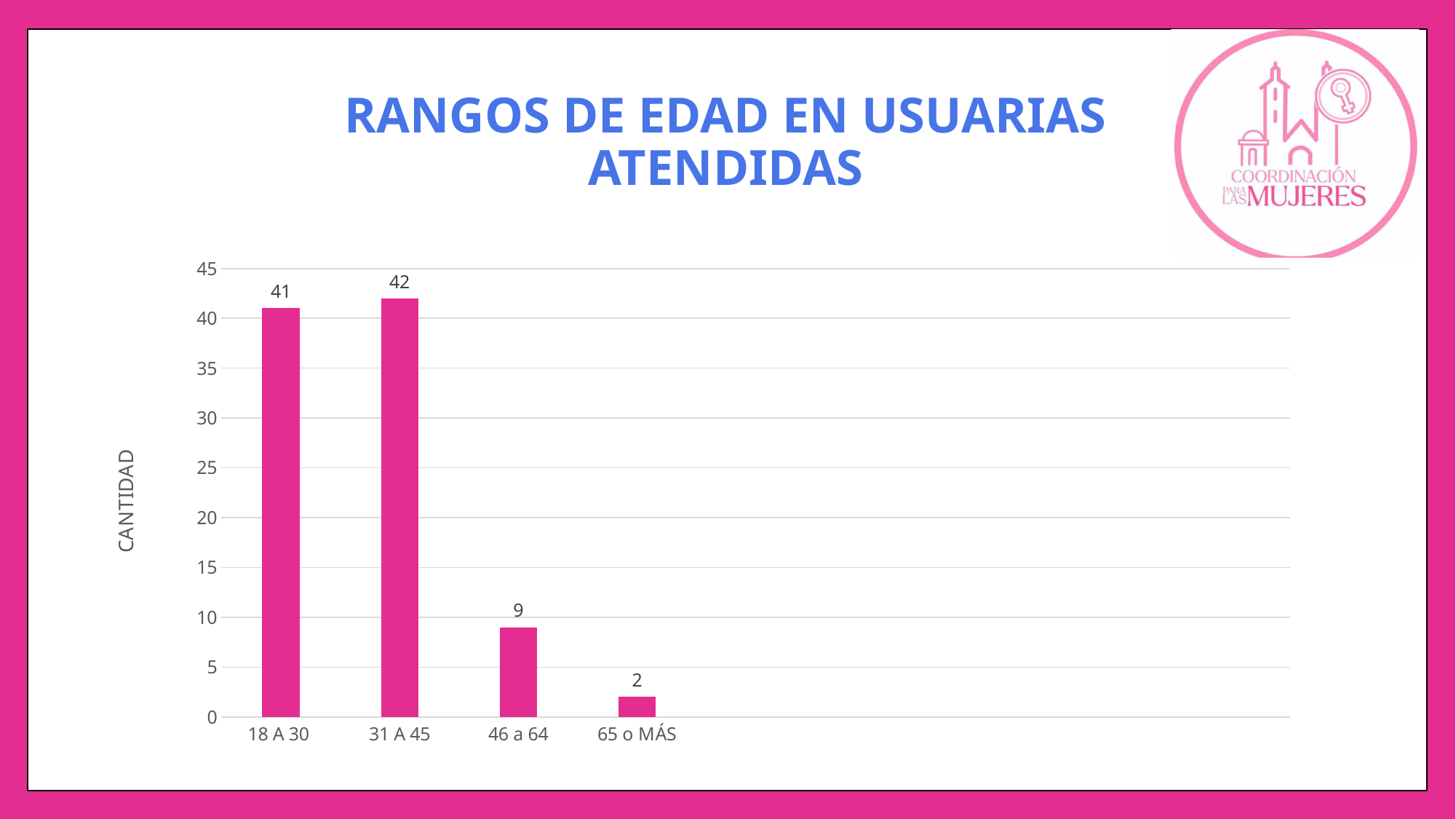
What is the value for the 46 a 64 age range? 9 Which is larger, the value for 18 A 30 or the value for 46 a 64? 18 A 30 What kind of chart is shown on the slide? Bar chart What is the value for the 18 A 30 age range? 41 Which age range has the highest value? 31 A 45 What is the difference between the values for 31 A 45 and 18 A 30? 1 How many age ranges are shown on the chart? 4 What is the value for the 65 o MÁS age range? 2 Which age range has the lowest value? 65 o MÁS What is the value for the 31 A 45 age range? 42 What is the label of the vertical axis? CANTIDAD What is the difference between the values for 46 a 64 and 65 o MÁS? 7